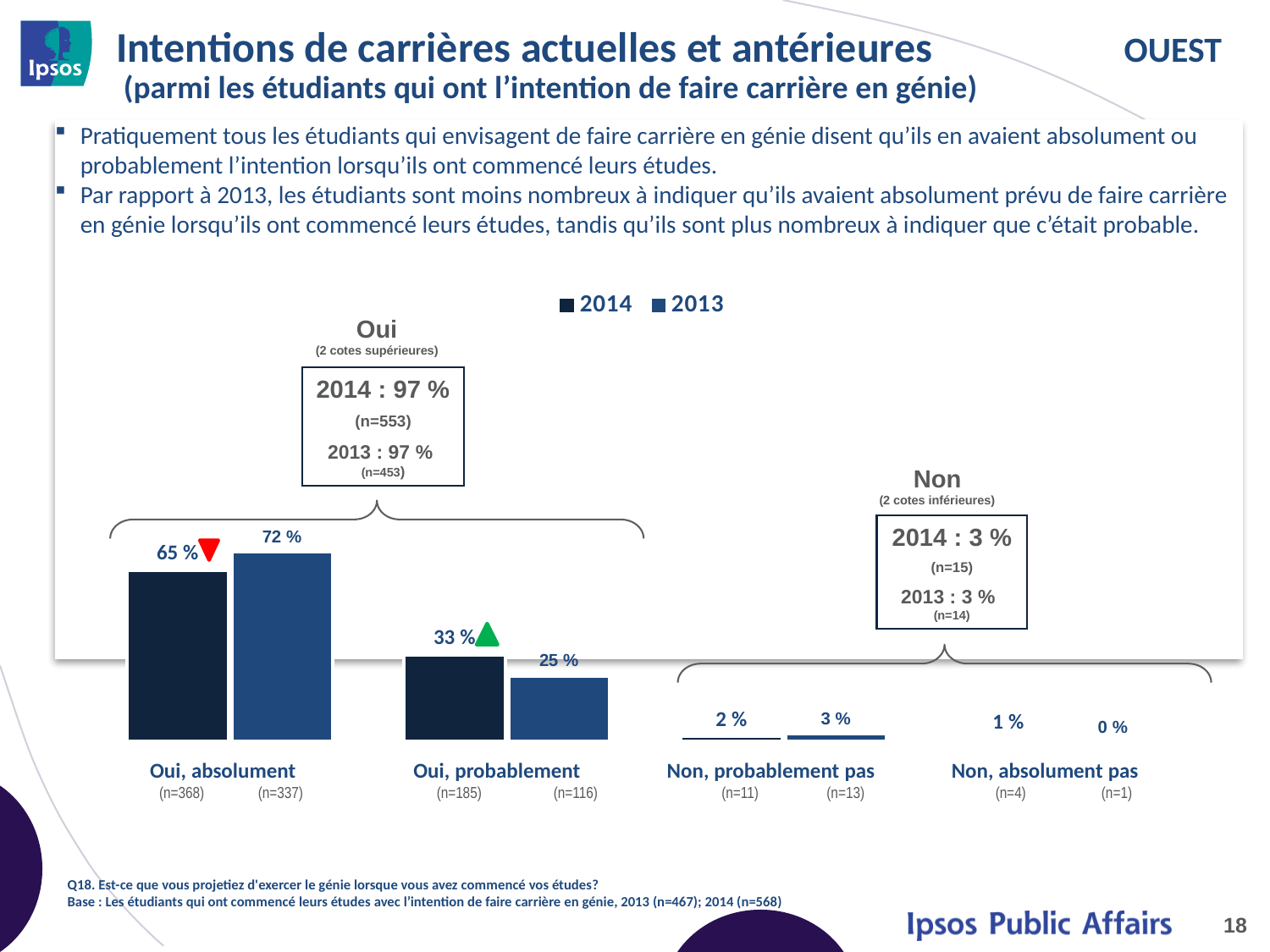
What kind of chart is shown on the slide? Bar chart Which category has the lowest 2013 value? Non, absolument pas What is the 2013 value for "Non, probablement pas"? 3 % What is the 2013 value for "Non, absolument pas"? 0 % What is the 2013 value for "Oui, probablement"? 25 % Which category has the highest 2014 value? Oui, absolument What is the 2014 value for "Oui, absolument"? 65 % What are the two series named in the chart legend? 2014 and 2013 How many series does the chart legend list? 2 What is the difference between the 2013 and 2014 values for "Oui, absolument"? 7 % For "Oui, probablement", which year has the larger value, 2014 or 2013? 2014 How many categories are shown on the x axis of the chart? 4